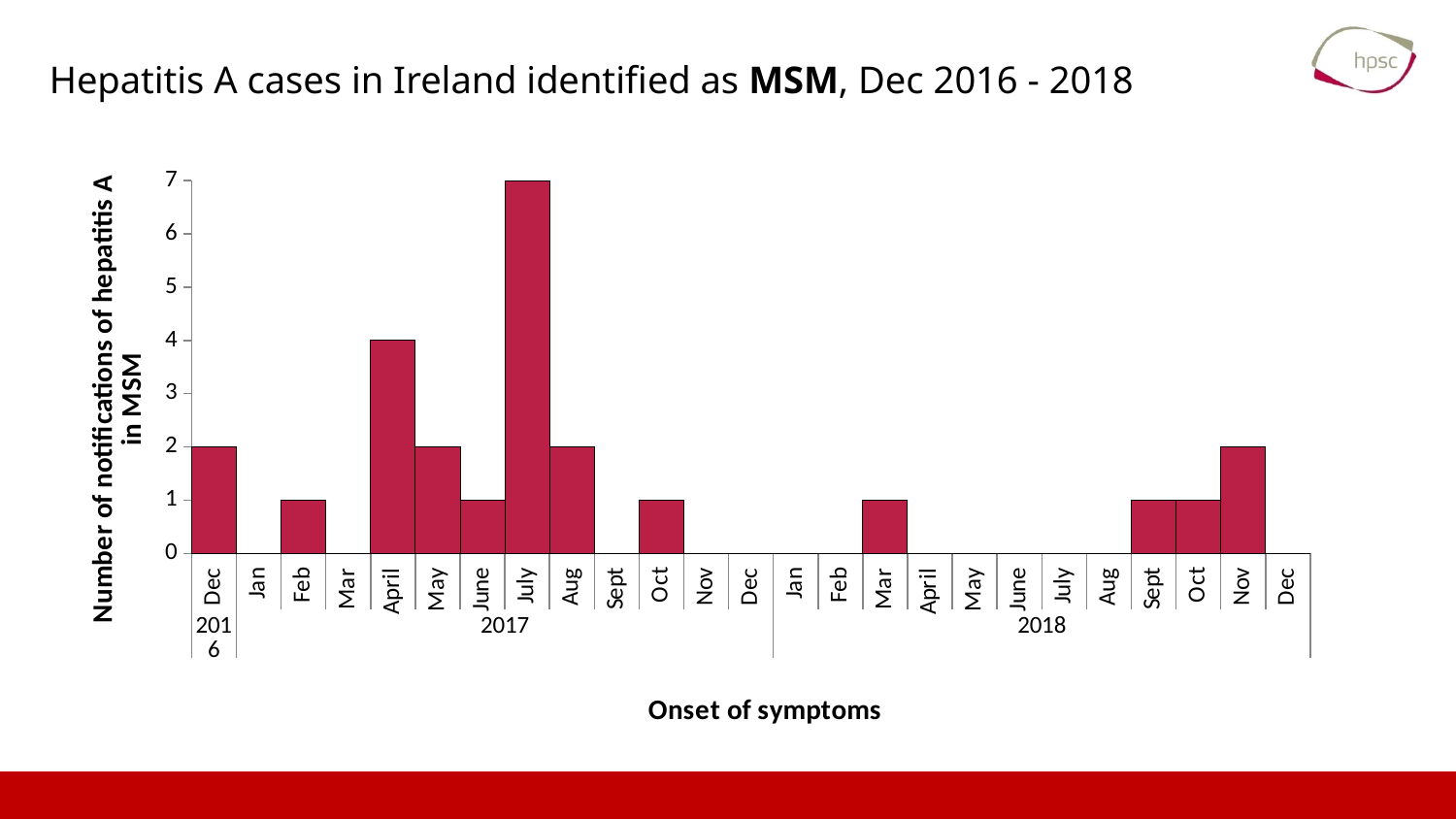
What is the total number of notifications with symptom onset in 2018? 5 Is the value for July 2017 greater or less than 5? greater What is the difference between the number of notifications in July 2017 and April 2017? 3 Which month of symptom onset has the highest number of notifications? July 2017 How many months are shown on the x axis of the chart? 25 What type of chart is shown on the slide? Bar chart Which month had more notifications, April 2017 or May 2017? April 2017 How many hepatitis A notifications in MSM had symptom onset in July 2017? 7 How many hepatitis A notifications in MSM had symptom onset in April 2017? 4 How many hepatitis A notifications in MSM had symptom onset in Nov 2018? 2 How many hepatitis A notifications in MSM had symptom onset in Dec 2016? 2 What is the title of the x axis of the chart? Onset of symptoms